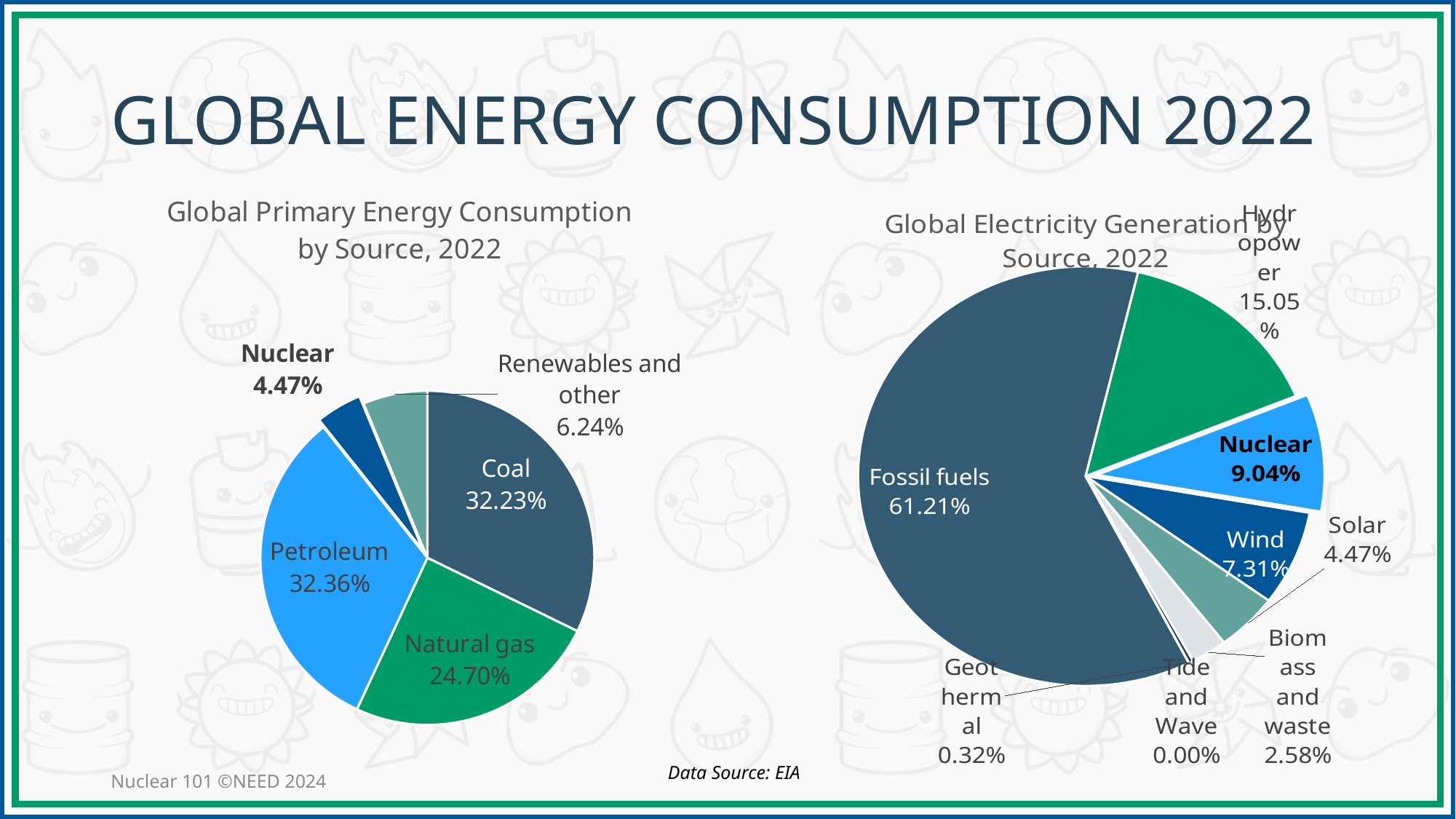
In the Global Primary Energy Consumption by Source, 2022 chart, what is the value for Nuclear? 4.47% In the Global Primary Energy Consumption by Source, 2022 chart, which source has the smallest share? Nuclear In the Global Electricity Generation by Source, 2022 chart, what is the value for Nuclear? 9.04% In the Global Primary Energy Consumption by Source, 2022 chart, how many slices does the pie have? 5 In the Global Electricity Generation by Source, 2022 chart, what is the difference between Hydropower and Nuclear? 6.01% In the Global Primary Energy Consumption by Source, 2022 chart, what share does Coal have? 32.23% In the Global Electricity Generation by Source, 2022 chart, which is larger, Wind or Solar? Wind In the Global Electricity Generation by Source, 2022 chart, which source has the largest share? Fossil fuels What type of chart is the Global Electricity Generation by Source, 2022 chart? Pie chart In the Global Primary Energy Consumption by Source, 2022 chart, what is the difference between Petroleum and Natural gas? 7.66% In the Global Electricity Generation by Source, 2022 chart, how many sources are shown? 8 In the Global Electricity Generation by Source, 2022 chart, what share does Fossil fuels have? 61.21%